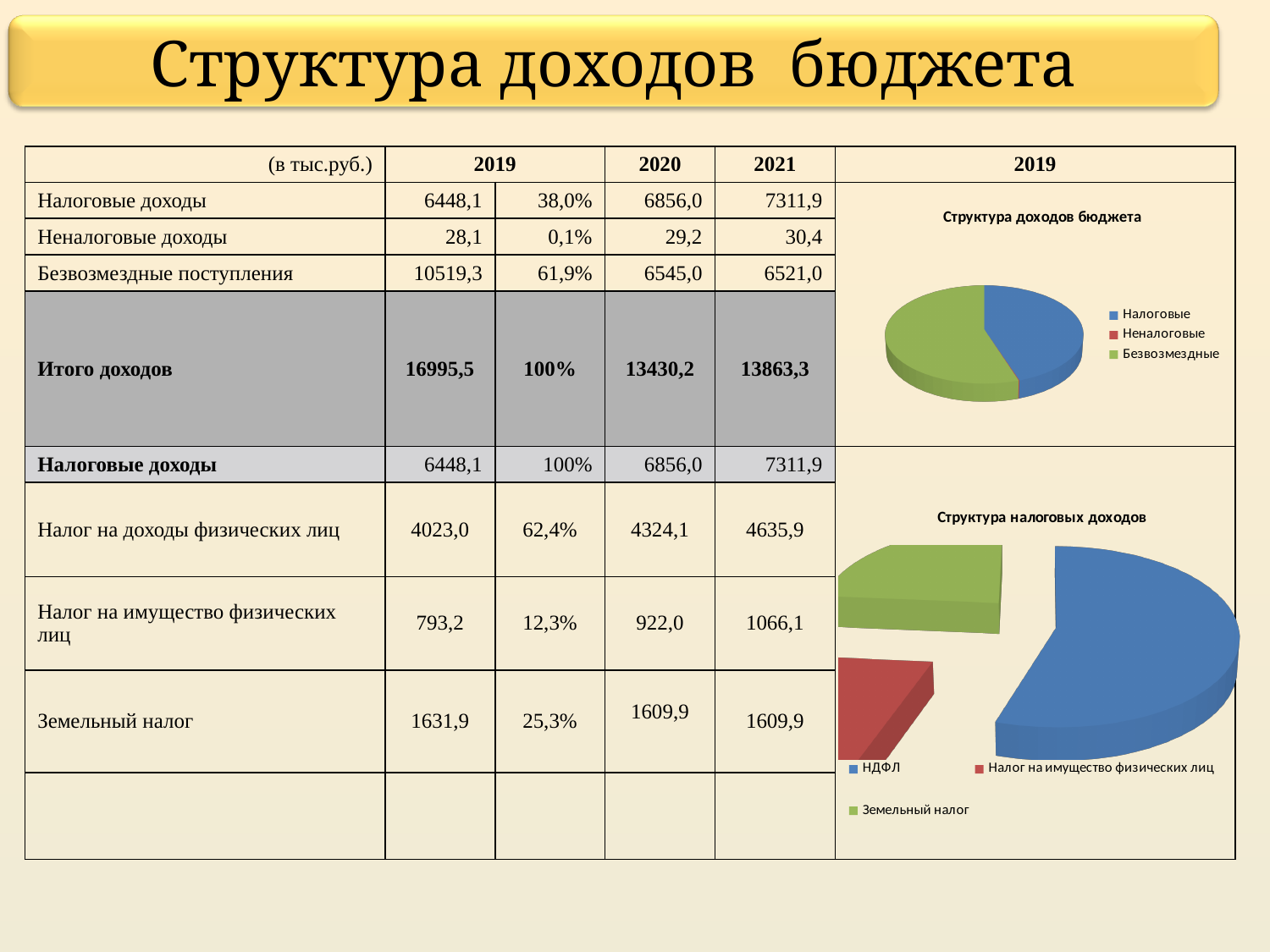
In the "Структура налоговых доходов" chart, which category has the largest slice? НДФЛ In the "Структура доходов бюджета" chart, which category has the largest slice? Безвозмездные In the "Структура доходов бюджета" chart, which category has the smallest slice? Неналоговые What kind of chart is the "Структура доходов бюджета" chart? pie chart In the "Структура налоговых доходов" chart, what colour is the НДФЛ slice? blue What kind of chart is the "Структура налоговых доходов" chart? pie chart How many slices does the "Структура налоговых доходов" chart have? 3 In the "Структура доходов бюджета" chart, what colour is the Безвозмездные slice? green In the "Структура налоговых доходов" chart, which category has the smallest slice? Налог на имущество физических лиц How many entries does the legend of the "Структура доходов бюджета" chart list? 3 In the "Структура налоговых доходов" chart, which slice is larger: Земельный налог or Налог на имущество физических лиц? Земельный налог In the "Структура доходов бюджета" chart, which slice is larger: Налоговые or Безвозмездные? Безвозмездные